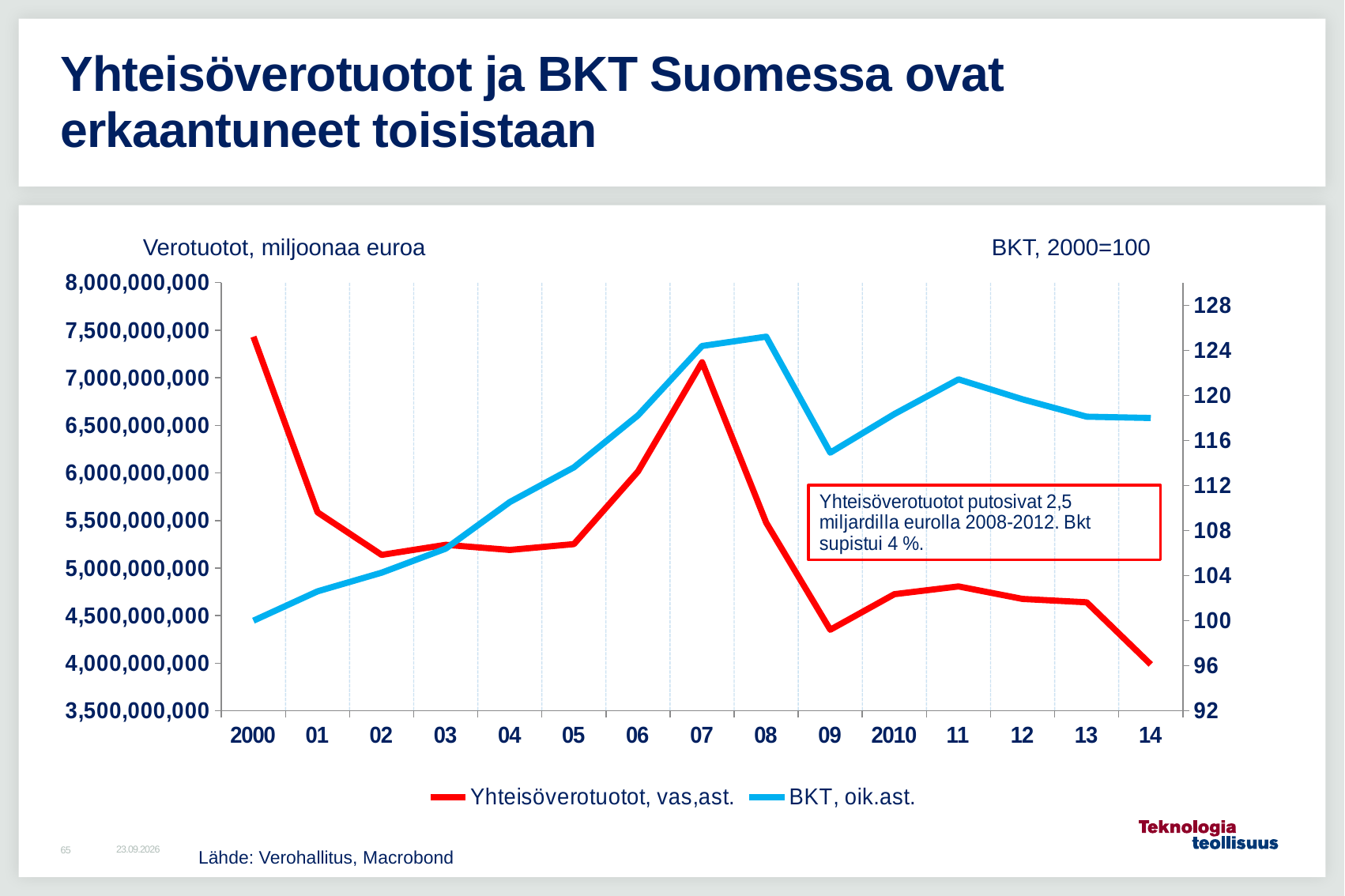
Is the value for BKT in 2000 greater or less than 104? less How many years are plotted along the x axis? 15 Is the value for BKT in 09 greater or less than 112? greater Is the value for Yhteisöverotuotot in 2000 greater or less than 7,000,000,000? greater In which year is the Yhteisöverotuotot line at its highest? 2000 Which is higher for BKT: the value in 11 or the value in 14? 11 Does the BKT line rise or fall between 2000 and 08? Rise In which year is the Yhteisöverotuotot line at its lowest? 14 What kind of chart is shown on the slide? Line chart How many series does the legend list? 2 In which year does the BKT line reach its highest value? 08